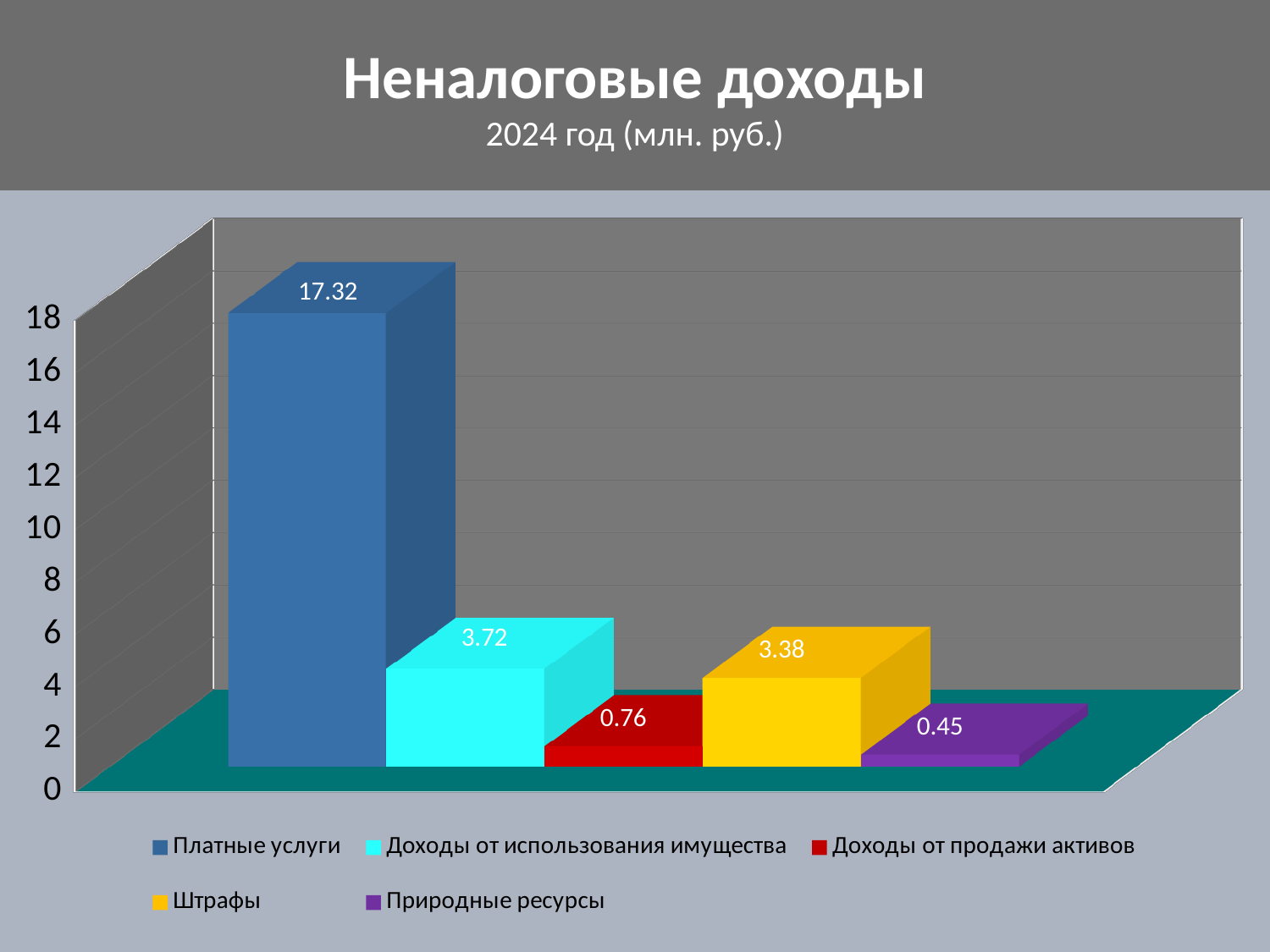
What is the value for Платные услуги? 17.32 What is the value for Штрафы? 3.38 What is the difference between Платные услуги and Доходы от использования имущества? 13.60 Which category has the lowest value? Природные ресурсы What is the title of the chart? Неналоговые доходы Which is larger, Доходы от использования имущества or Штрафы? Доходы от использования имущества What kind of chart is shown? bar chart How many series does the legend list? 5 What is the value for Доходы от использования имущества? 3.72 Which category has the highest value? Платные услуги What is the value for Природные ресурсы? 0.45 What is the difference between Доходы от продажи активов and Природные ресурсы? 0.31